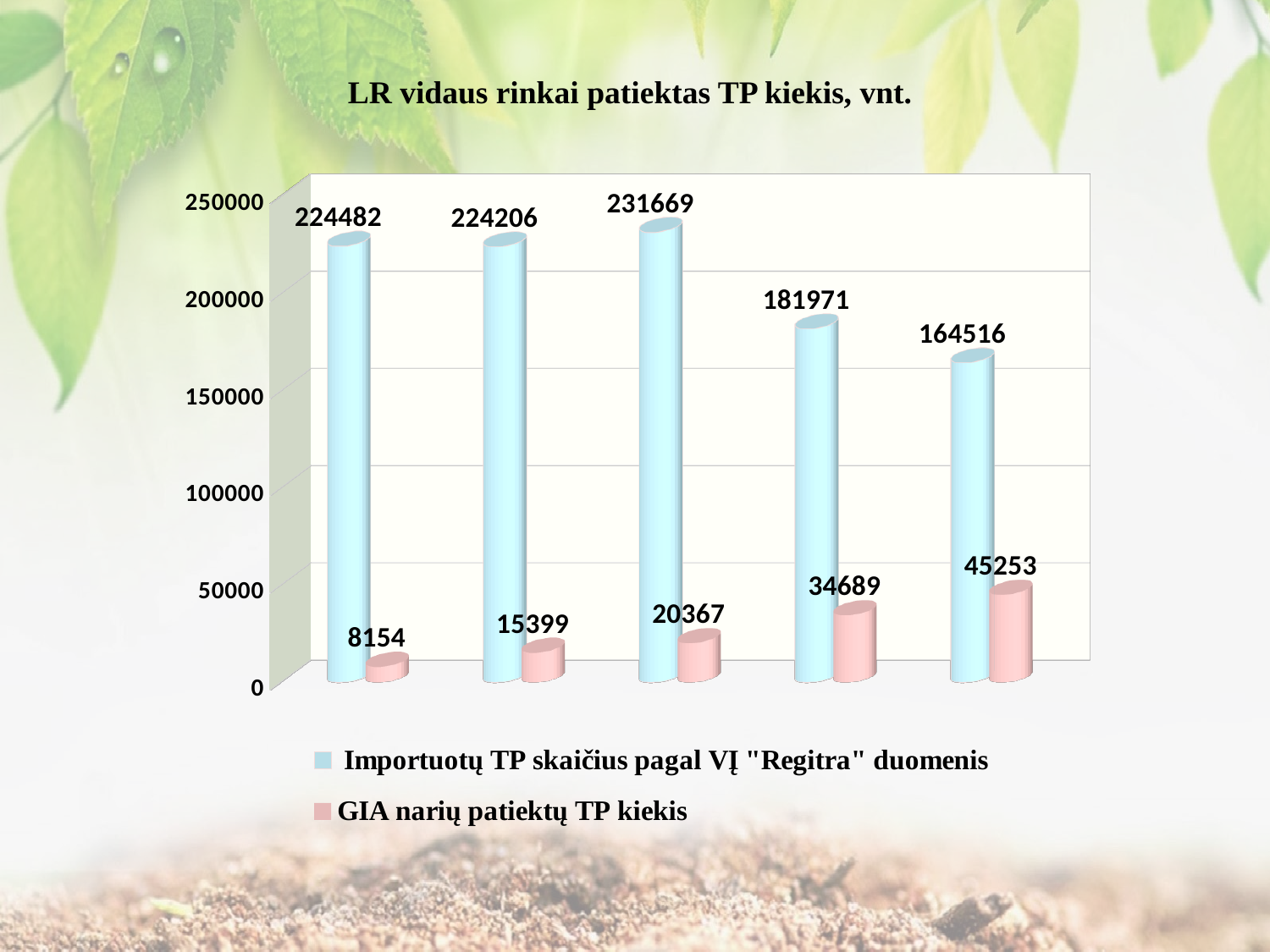
How many series does the legend list? 2 What is the lowest value in the series 'GIA narių patiektų TP kiekis'? 8154 How many groups of bars are plotted in the chart? 5 What is the highest value in the series 'GIA narių patiektų TP kiekis'? 45253 What is the value of 'GIA narių patiektų TP kiekis' in the fourth group of bars from the left? 34689 In the leftmost group of bars, what is the difference between the 'Importuotų TP skaičius pagal VĮ "Regitra" duomenis' value and the 'GIA narių patiektų TP kiekis' value? 216328 What is the lowest value in the series 'Importuotų TP skaičius pagal VĮ "Regitra" duomenis'? 164516 What is the highest value in the series 'Importuotų TP skaičius pagal VĮ "Regitra" duomenis'? 231669 What kind of chart is shown on the slide? bar chart Do the values of 'GIA narių patiektų TP kiekis' rise or fall from left to right along the x axis? rise Which is larger for 'Importuotų TP skaičius pagal VĮ "Regitra" duomenis': the fourth group from the left or the fifth group from the left? the fourth group (181971) What is the title of the chart? LR vidaus rinkai patiektas TP kiekis, vnt.